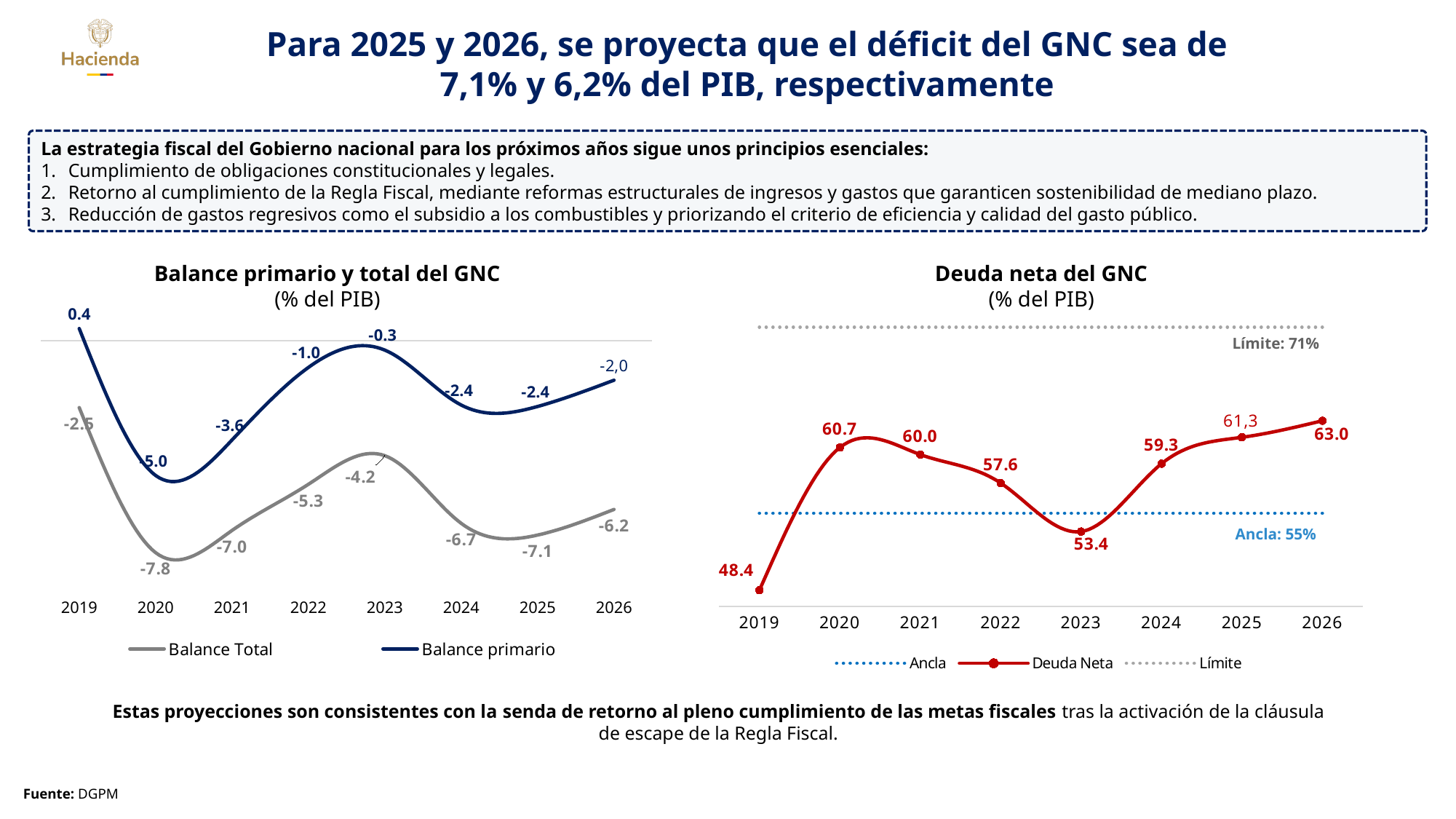
In the 'Deuda neta del GNC' chart, how many series does the legend list? 3 In the 'Balance primario y total del GNC' chart, how many years are shown on the x axis? 8 In the 'Balance primario y total del GNC' chart, what is the Balance primario value for 2023? -0.3 In the 'Balance primario y total del GNC' chart, what is the Balance Total value for 2020? -7.8 In the 'Deuda neta del GNC' chart, what is the value for 2023? 53.4 In the 'Deuda neta del GNC' chart, which year has the lowest net debt value? 2019 In the 'Deuda neta del GNC' chart, what is the difference between the 2020 value and the 2019 value? 12.3 What kind of chart is the 'Balance primario y total del GNC' chart? Line chart In the 'Deuda neta del GNC' chart, which year has the highest net debt value? 2026 In the 'Balance primario y total del GNC' chart, which is larger in 2025: Balance Total or Balance primario? Balance primario In the 'Deuda neta del GNC' chart, what value is shown for the 'Límite' line? 71% In the 'Balance primario y total del GNC' chart, which year has the lowest Balance Total value? 2020